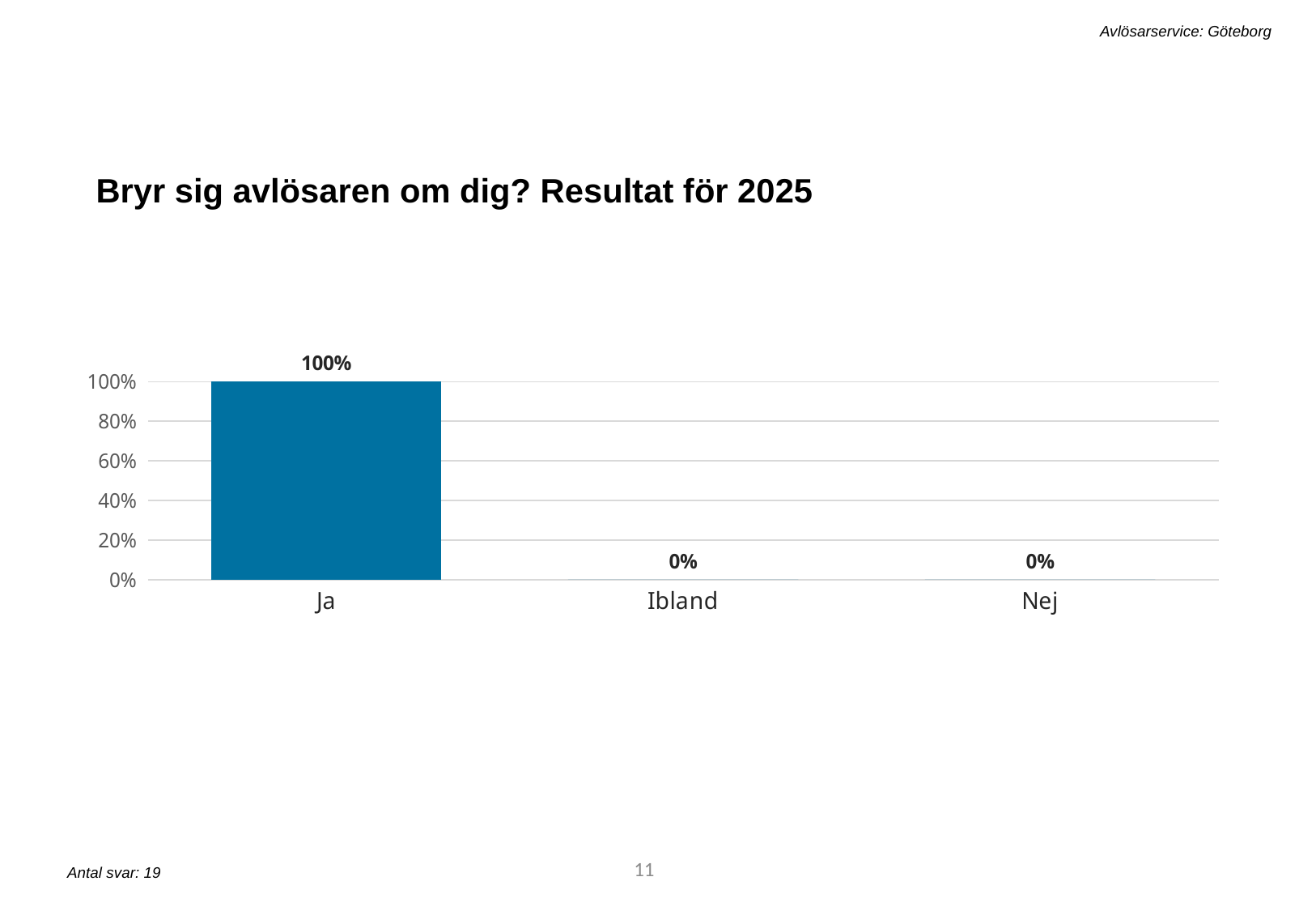
Which is larger, the value for Ja or the value for Ibland? Ja What is the title of the chart? Bryr sig avlösaren om dig? Resultat för 2025 What is the value for Ja? 100% Is the value for Ja greater or less than 80%? greater How many categories are shown on the x axis? 3 What is the value for Nej? 0% What kind of chart is shown on the slide? bar chart What is the total of the values for Ja, Ibland and Nej? 100% What is the value for Ibland? 0% Which category has the highest value? Ja What is the difference between the values for Ja and Nej? 100% What is the highest value shown on the y axis? 100%